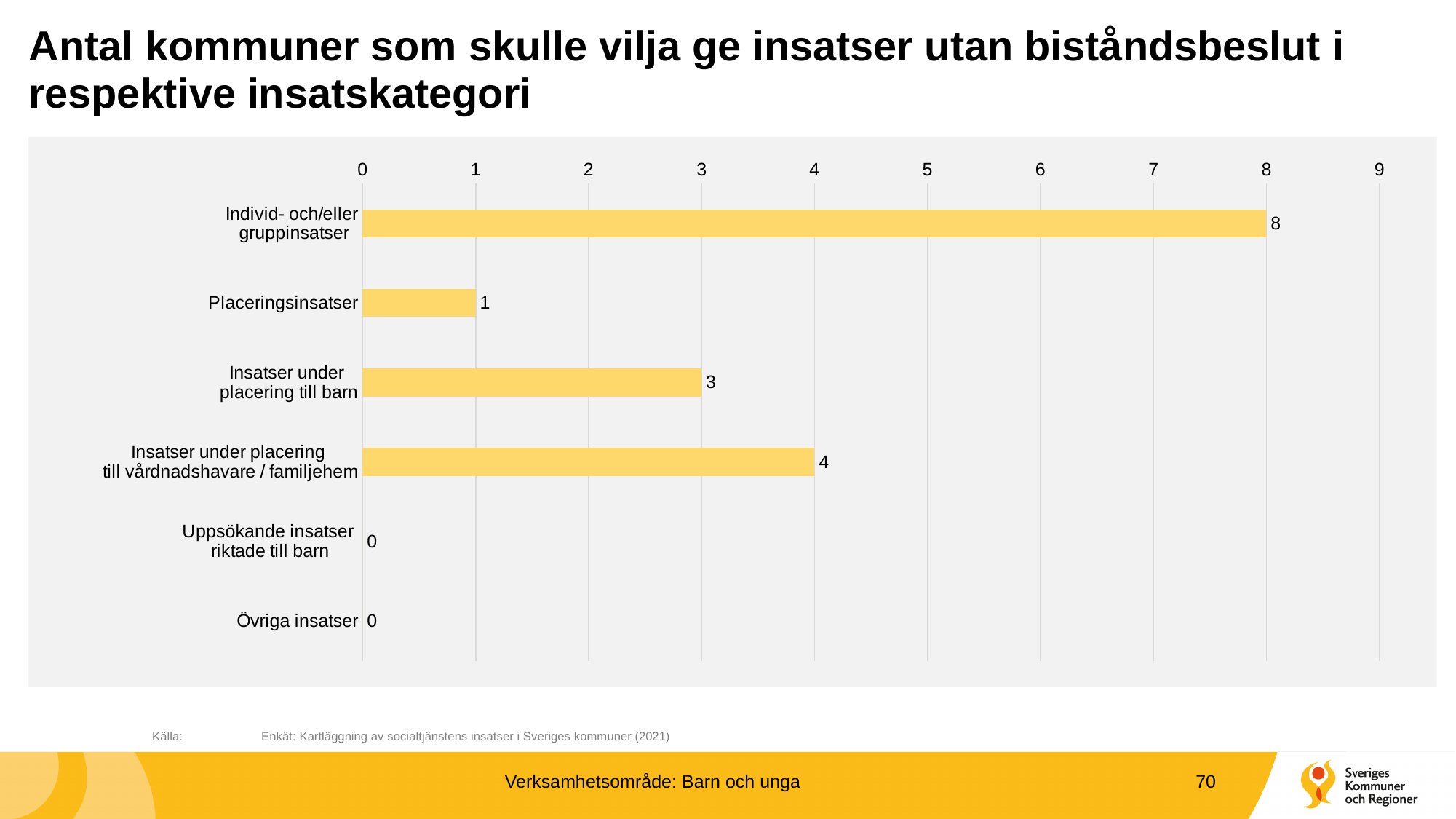
What is the value for Uppsökande insatser riktade till barn? 0 How many categories have a value of 0? 2 What kind of chart is shown on the slide? Bar chart How many categories are shown in the chart? 6 What is the value for Insatser under placering till barn? 3 Which is larger: the value for Insatser under placering till barn or the value for Placeringsinsatser? Insatser under placering till barn What is the value for Individ- och/eller gruppinsatser? 8 What is the value for Placeringsinsatser? 1 Which category has the highest value? Individ- och/eller gruppinsatser Is the value for Individ- och/eller gruppinsatser greater or less than 5? greater What is the value for Insatser under placering till vårdnadshavare / familjehem? 4 What is the difference between the values for Individ- och/eller gruppinsatser and Insatser under placering till vårdnadshavare / familjehem? 4